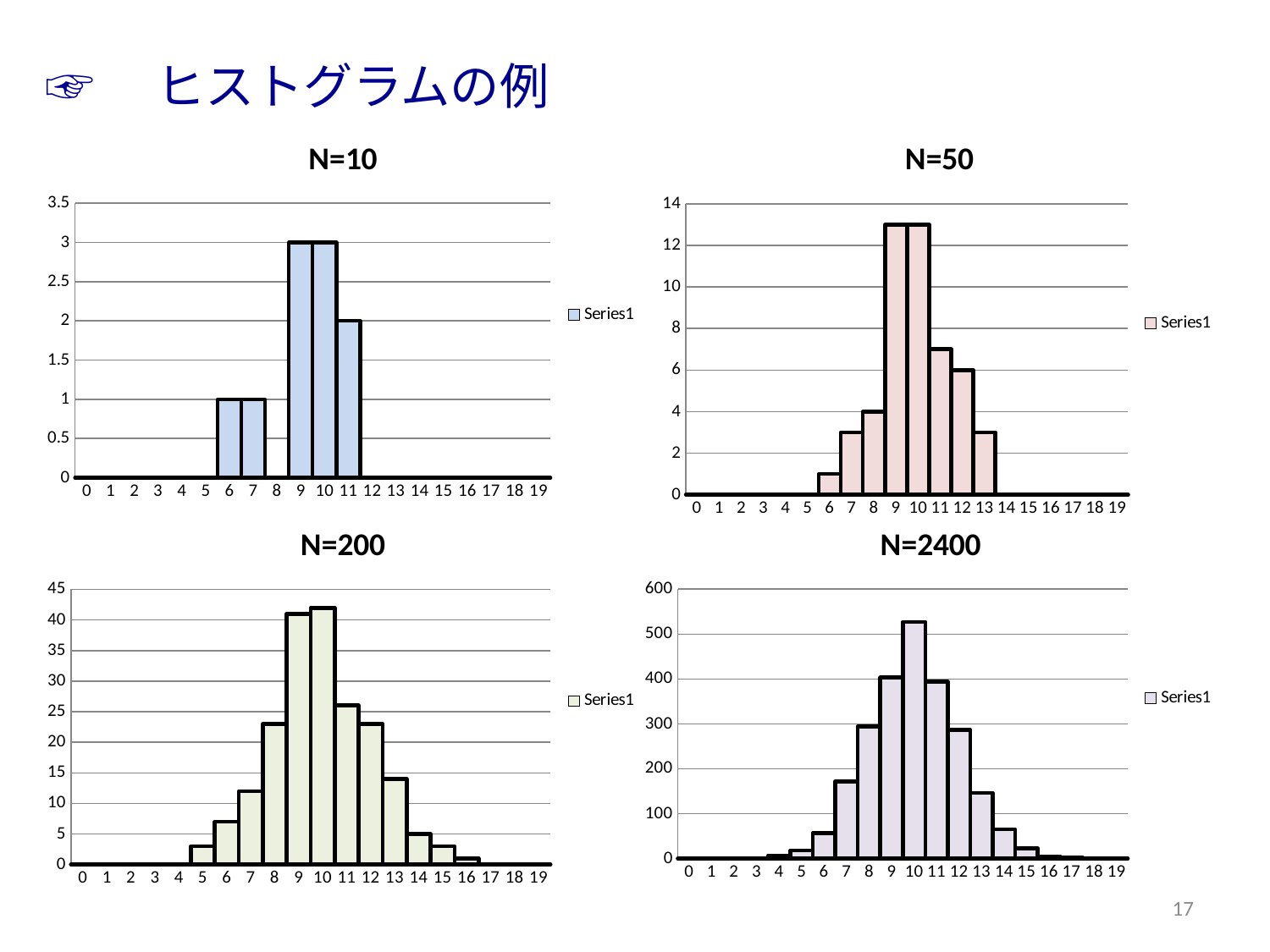
How many series does the legend of the N=2400 chart list? 1 In the N=10 chart, what is the value for category 11? 2 In the N=50 chart, what is the value for category 8? 4 In the N=200 chart, what is the value for category 14? 5 In the N=10 chart, what is the value for category 9? 3 In the N=200 chart, is the value for category 8 greater or less than 20? greater In the N=2400 chart, is the value for category 10 greater or less than 500? greater In the N=50 chart, what is the value for category 12? 6 In the N=50 chart, is the value for category 9 greater or less than 12? greater In the N=2400 chart, which category has the highest value? 10 In the N=10 chart, what is the difference between the values for categories 9 and 11? 1 In the N=2400 chart, which is larger, the value for category 8 or category 13? 8